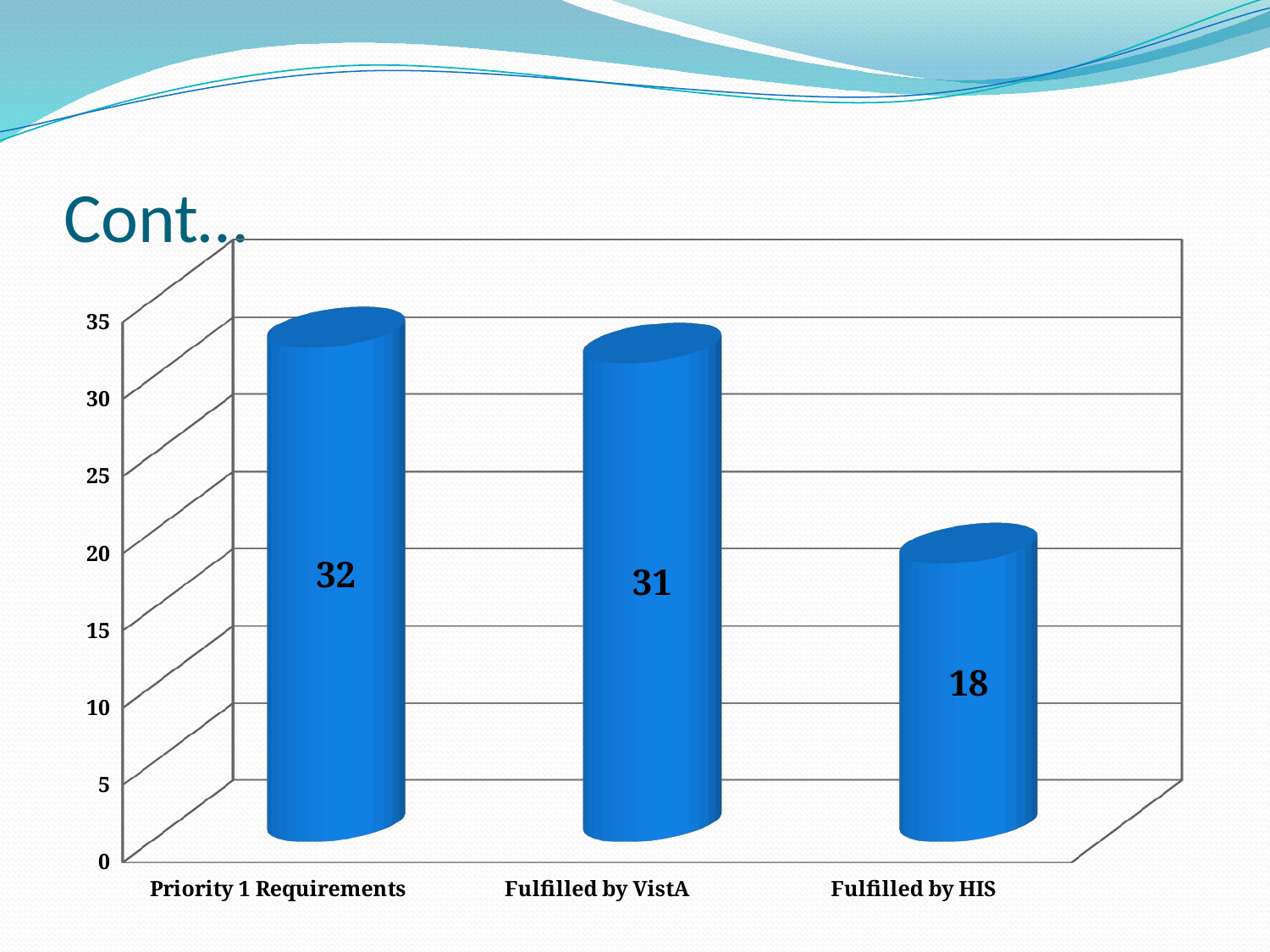
Which category has the highest value? Priority 1 Requirements What is the difference between the values for Fulfilled by VistA and Fulfilled by HIS? 13 What is the title of the slide? Cont... What kind of chart is shown on the slide? bar chart How many categories are shown on the chart? 3 Which category has the lowest value? Fulfilled by HIS What is the difference between the values for Priority 1 Requirements and Fulfilled by HIS? 14 Which is larger, the value for Fulfilled by VistA or the value for Fulfilled by HIS? Fulfilled by VistA Is the value for Fulfilled by HIS greater or less than 20? less What is the value for Fulfilled by VistA? 31 What is the value for Fulfilled by HIS? 18 What is the value for Priority 1 Requirements? 32